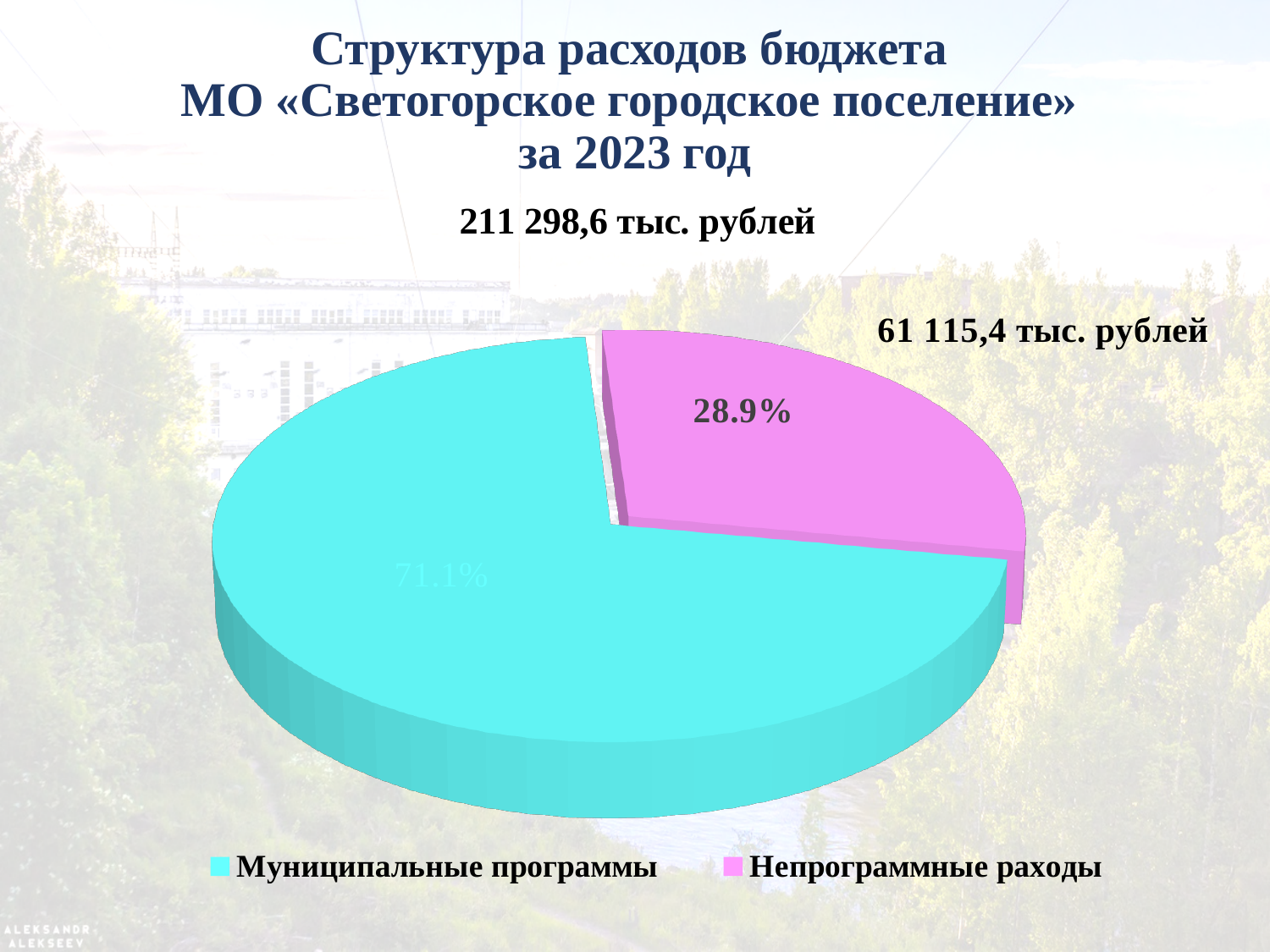
How many slices does the pie chart have? 2 What share of the pie does Муниципальные программы take? 71.1% What is the difference in percentage points between the Муниципальные программы and Непрограммные раходы shares? 42.2 What share of the pie does Непрограммные раходы take? 28.9% Which category has the smallest share of the pie? Непрограммные раходы Which category has the largest share of the pie? Муниципальные программы What value is printed next to the Непрограммные раходы slice? 61 115,4 тыс. рублей What colour is the Непрограммные раходы slice? pink Which is larger, the share for Муниципальные программы or for Непрограммные раходы? Муниципальные программы What kind of chart is shown on the slide? pie chart How many entries does the legend list? 2